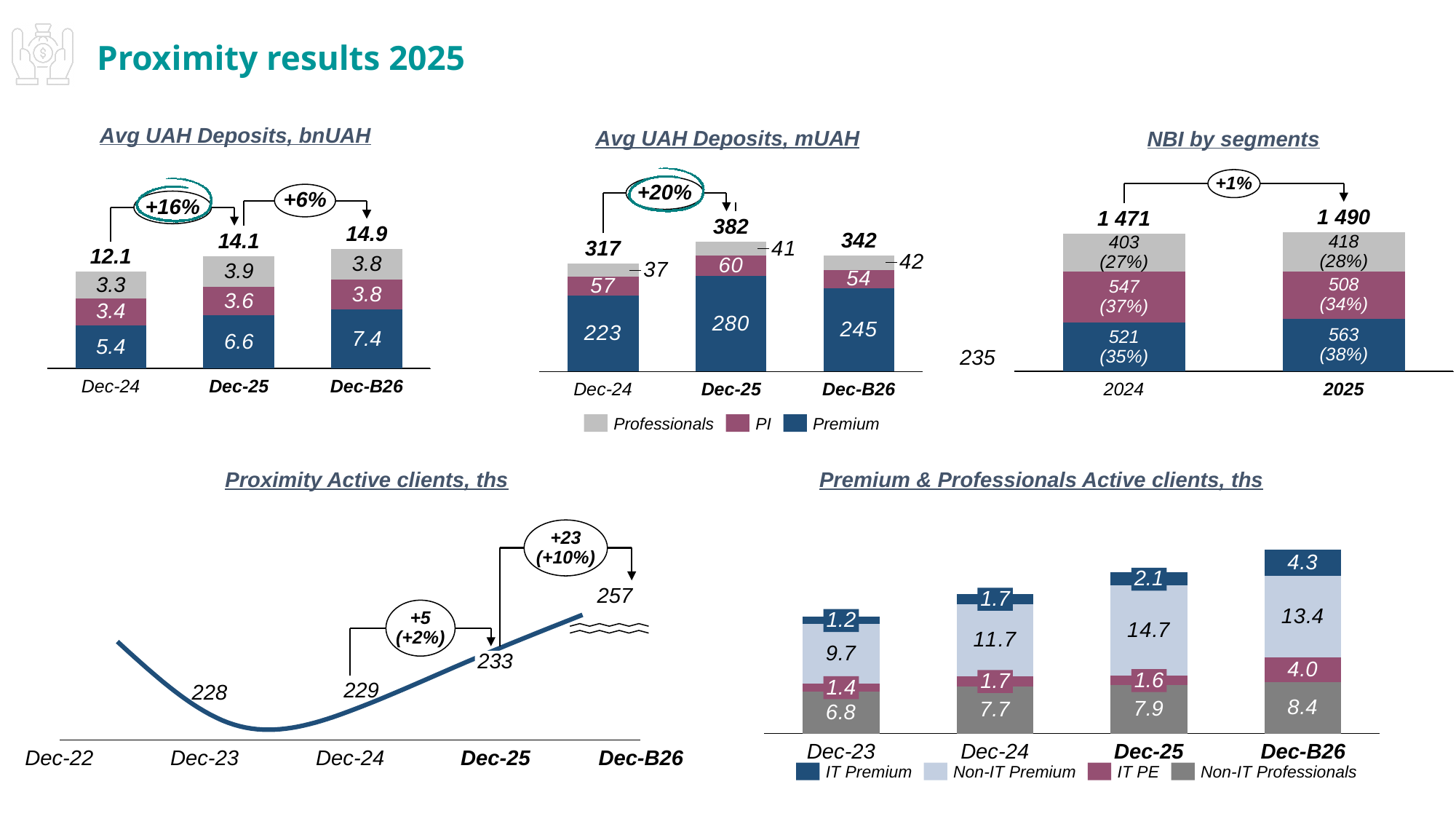
In the 'Premium & Professionals Active clients, ths' chart, which is larger: IT Premium for Dec-B26 or IT Premium for Dec-25? Dec-B26 In the 'NBI by segments' chart, what is the total for 2024? 1 471 In the 'Avg UAH Deposits, mUAH' chart, what is the difference between the totals for Dec-25 and Dec-24? 65 In the 'Avg UAH Deposits, mUAH' chart, what is the Premium value for Dec-25? 280 How many series does the legend of the 'Avg UAH Deposits, mUAH' chart list? 3 In the 'Proximity Active clients, ths' chart, what is the value for Dec-B26? 257 In the 'Avg UAH Deposits, mUAH' chart, which period has the highest total? Dec-25 In the 'Avg UAH Deposits, bnUAH' chart, what is the total value for Dec-25? 14.1 What kind of chart is 'Proximity Active clients, ths'? Line chart In the 'NBI by segments' chart, what is the Premium value for 2025? 563 (38%) In the 'Avg UAH Deposits, bnUAH' chart, what is the Premium value for Dec-B26? 7.4 In the 'Premium & Professionals Active clients, ths' chart, what is the Non-IT Premium value for Dec-25? 14.7